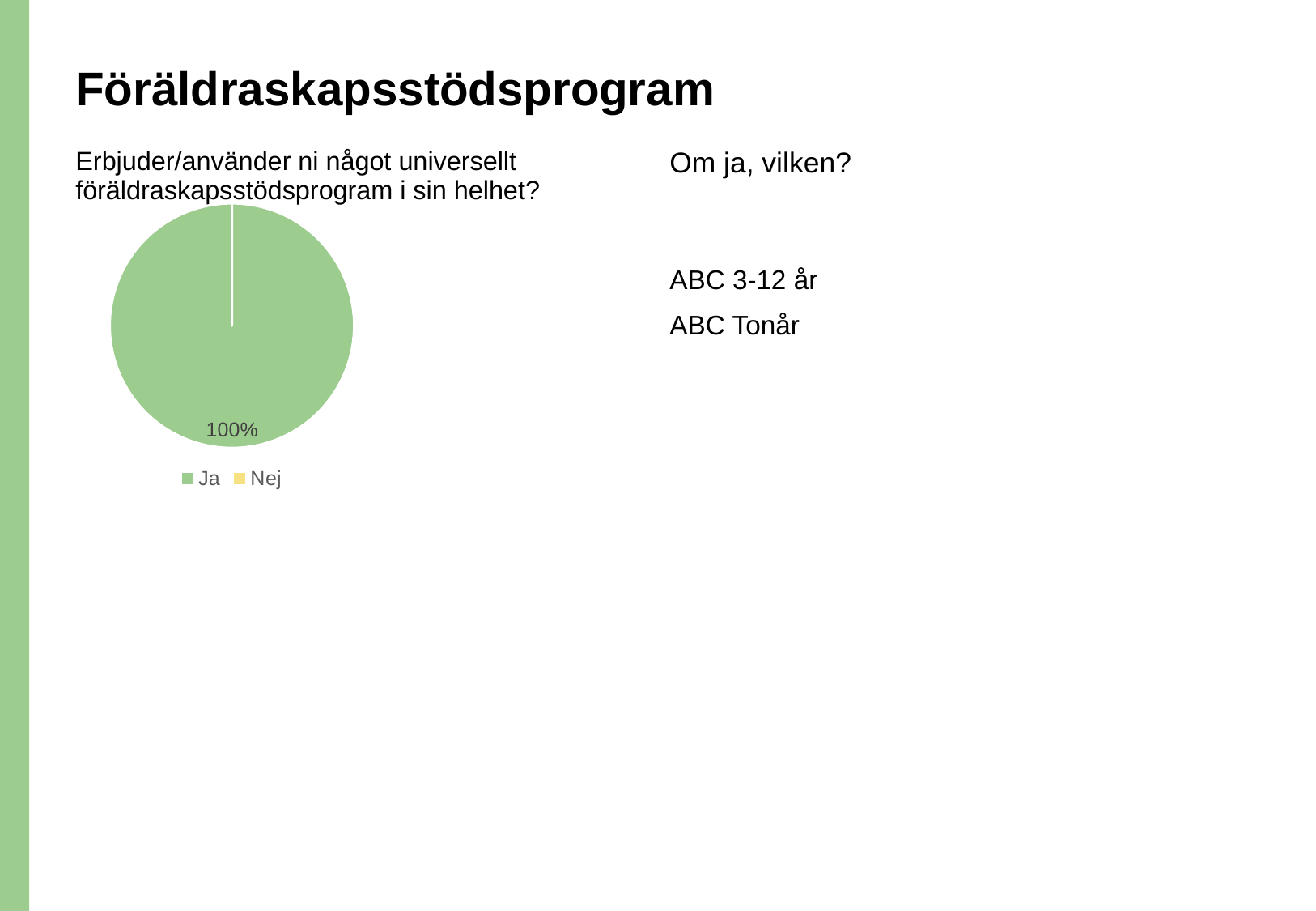
Which is larger in the pie chart, "Ja" or "Nej"? Ja How many slices are visible in the pie chart? 1 What are the two legend entries of the pie chart? Ja, Nej What colour is the "Ja" slice in the pie chart? green What share of the pie does "Ja" represent? 100% How many entries does the legend of the pie chart list? 2 What value is printed on the pie chart? 100% What kind of chart is shown on the slide? pie chart Which category has the largest share of the pie? Ja